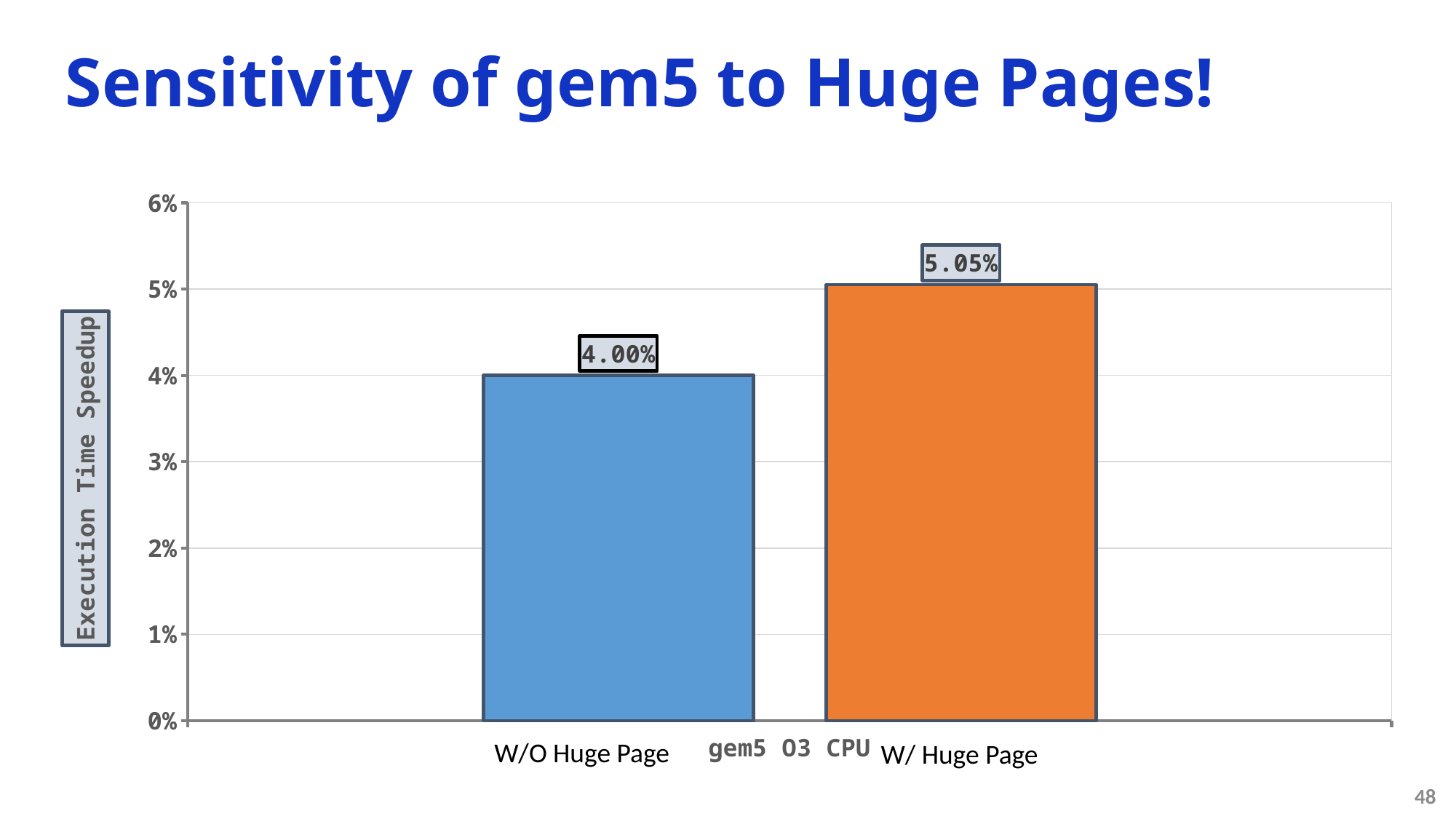
Is the value for W/O Huge Page greater or less than 3%? greater Is the Execution Time Speedup larger for W/ Huge Page or W/O Huge Page? W/ Huge Page Which category has the lower Execution Time Speedup? W/O Huge Page What is the label shown on the x axis between the two bars? gem5 O3 CPU What is the difference in Execution Time Speedup between W/ Huge Page and W/O Huge Page? 1.05% Which category has the higher Execution Time Speedup? W/ Huge Page Is the value for W/ Huge Page greater or less than 5%? greater What kind of chart is shown on the slide? Bar chart What is the label of the y axis? Execution Time Speedup How many bars are shown in the chart? 2 What is the Execution Time Speedup for W/O Huge Page? 4.00% What is the Execution Time Speedup for W/ Huge Page? 5.05%